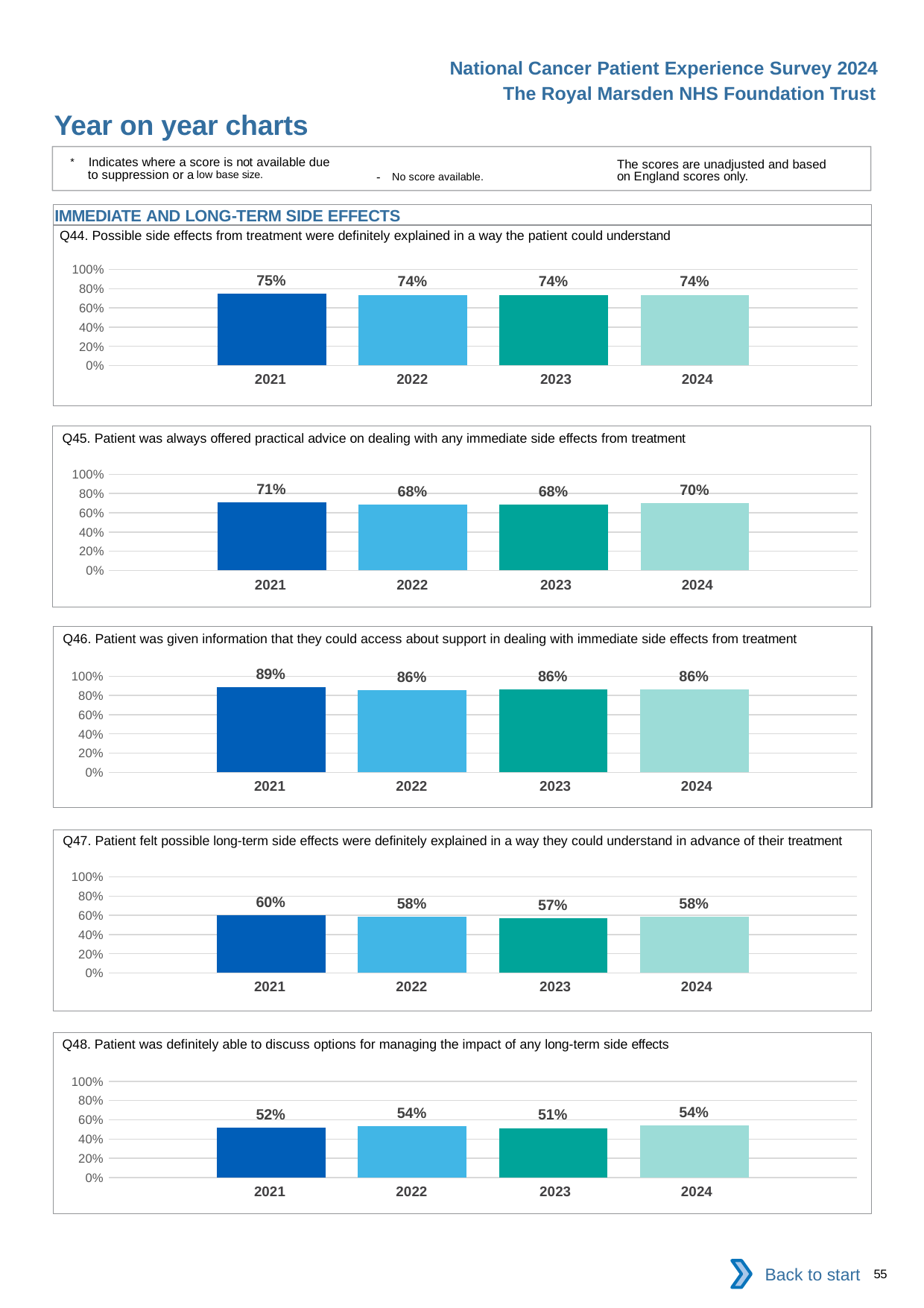
How many charts are shown on the slide? 5 In the Q46 chart, what is the value for 2024? 86% In the Q46 chart, what is the difference between the 2021 value and the 2023 value? 3 percentage points In the Q48 chart, what is the value for 2023? 51% In the Q44 chart, what is the value for 2021? 75% In the Q48 chart, is the value for 2022 greater or less than 60%? less How many years are shown on the x axis of the Q44 chart? 4 In the Q45 chart, what is the difference between the 2021 and 2022 values? 3 percentage points In the Q45 chart, which year has the highest value? 2021 In the Q47 chart, which year has the lowest value? 2023 In the Q47 chart, is the value for 2021 larger or smaller than the value for 2024? larger What type of chart is used for Q45? bar chart